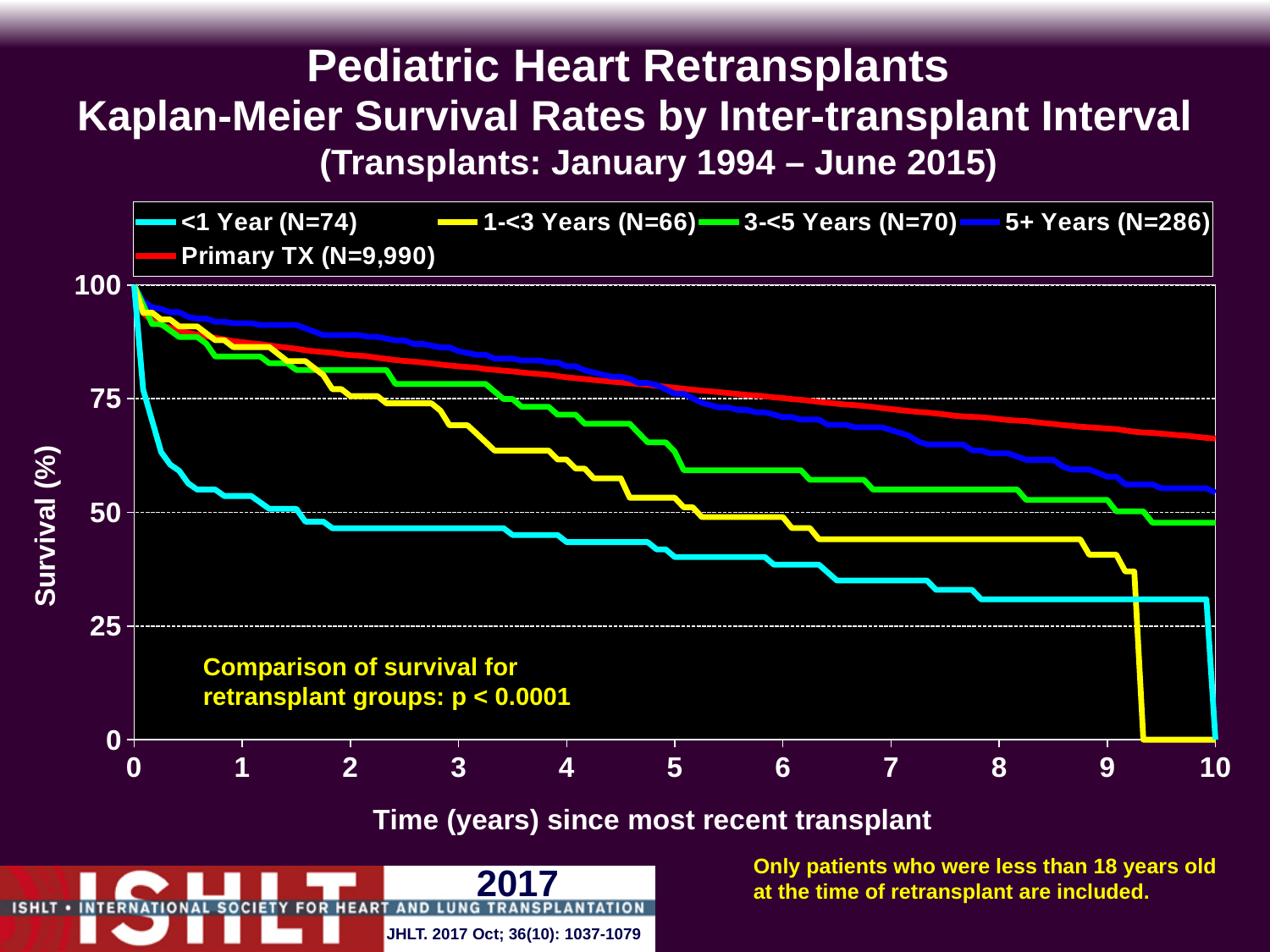
Is the survival value for the <1 Year group at 5 years greater or less than 50? less Is the survival value for the 5+ Years group at 3 years greater or less than 75? greater What is the p-value shown for the comparison of survival for retransplant groups? p < 0.0001 Is the survival value for the Primary TX group at 10 years greater or less than 50? greater How many series does the legend list? 5 At 5 years, which group has higher survival: <1 Year or Primary TX? Primary TX Which group has the highest survival at 2 years? 5+ Years What kind of chart is shown on the slide? line chart Do the survival curves rise or fall as time since transplant increases? fall Which group has the lowest survival at 5 years? <1 Year